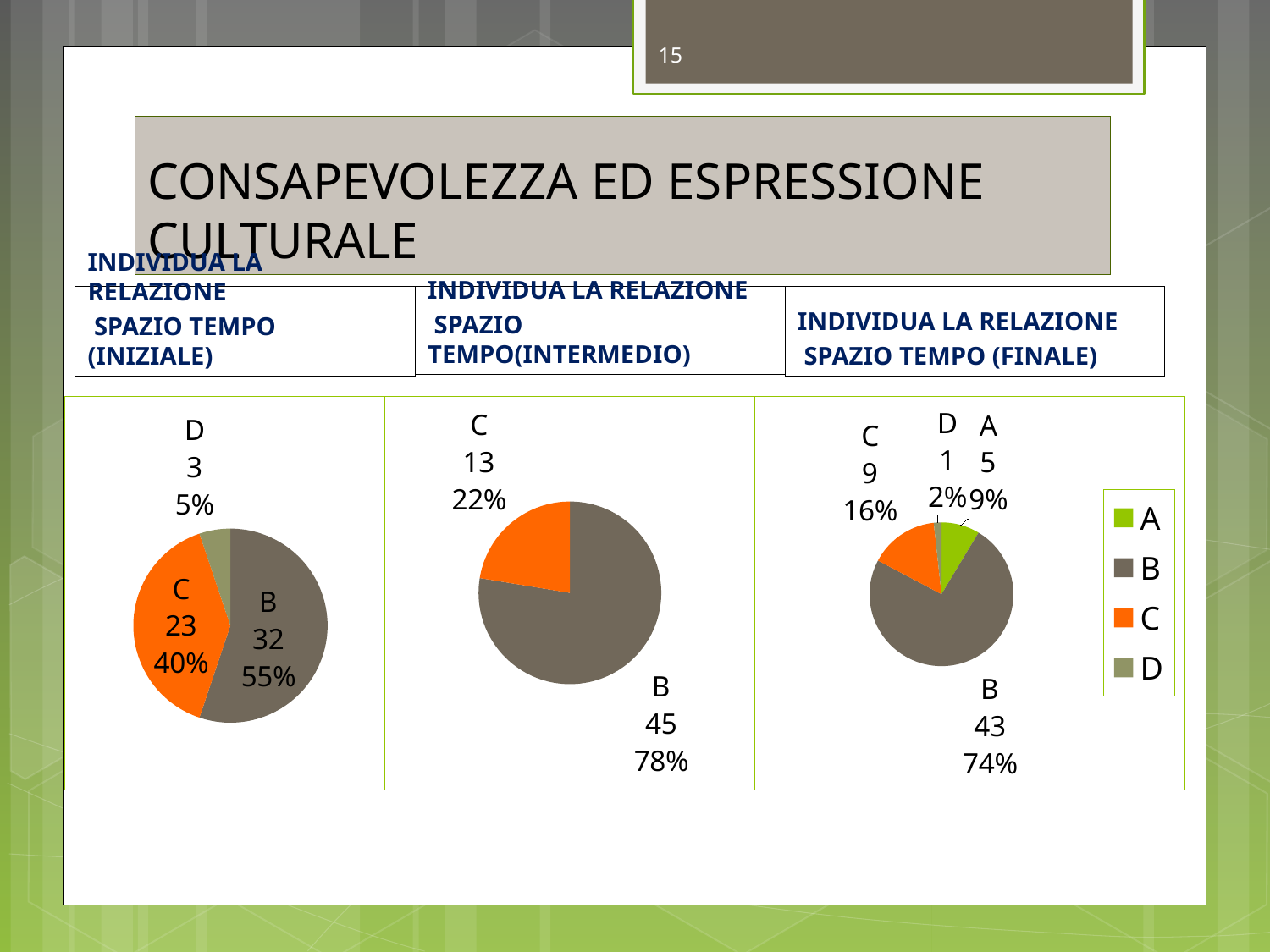
How many entries does the legend on the slide list? 4 In the FINALE (right) chart, what is the value for A? 5 In the FINALE (right) chart, is the value for C larger or smaller than the value for A? larger In the INIZIALE (left) chart, what share of the pie does C represent? 40% In the INIZIALE (left) chart, which category has the smallest slice? D In the INIZIALE (left) chart, what is the value for B? 32 In the INTERMEDIO (middle) chart, what share of the pie does B represent? 78% In the FINALE (right) chart, which category has the largest slice? B How many slices does the INTERMEDIO (middle) chart have? 2 In the INTERMEDIO (middle) chart, what is the value for C? 13 In the INIZIALE (left) chart, what is the difference between the values for B and C? 9 What kind of chart is used in the INIZIALE (left) chart? pie chart